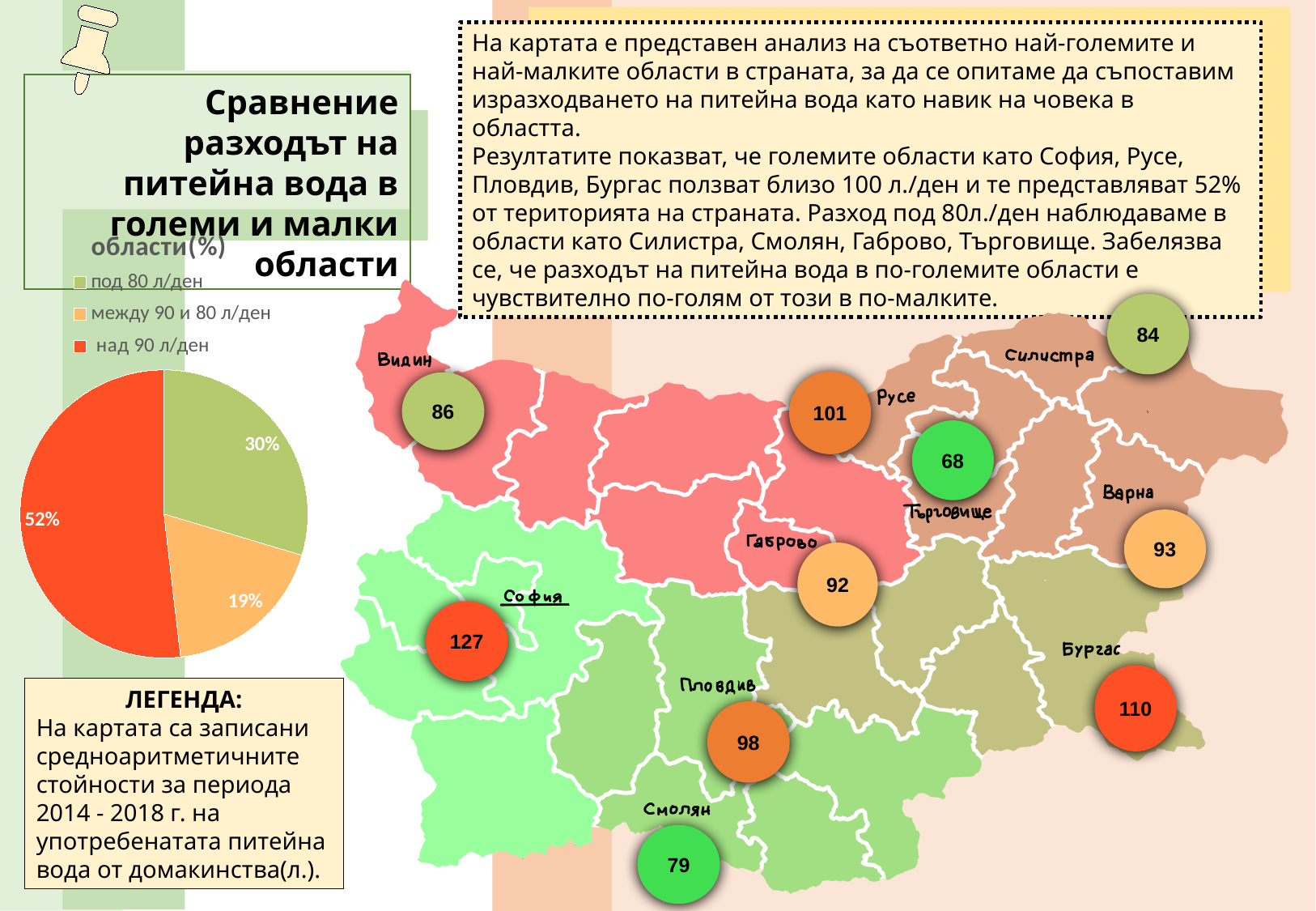
What kind of chart is the chart titled "области(%)" on the left of the slide? pie chart In the pie chart "области(%)", which slice is larger: "под 80 л/ден" or "между 90 и 80 л/ден"? под 80 л/ден In the pie chart "области(%)", what is the difference in percentage points between the "над 90 л/ден" slice and the "под 80 л/ден" slice? 22 In the pie chart "области(%)", which category has the smallest slice? между 90 и 80 л/ден How many slices does the pie chart "области(%)" have? 3 On the map of Bulgaria, what value is shown for София? 127 In the pie chart "области(%)", which category has the largest slice? над 90 л/ден In the pie chart "области(%)", what colour is the "над 90 л/ден" slice? red On the map of Bulgaria, which labelled region has the lowest value? Търговище In the pie chart "области(%)", what share is shown for "над 90 л/ден"? 52% In the pie chart "области(%)", what share is shown for "между 90 и 80 л/ден"? 19% In the pie chart "области(%)", what share is shown for "под 80 л/ден"? 30%